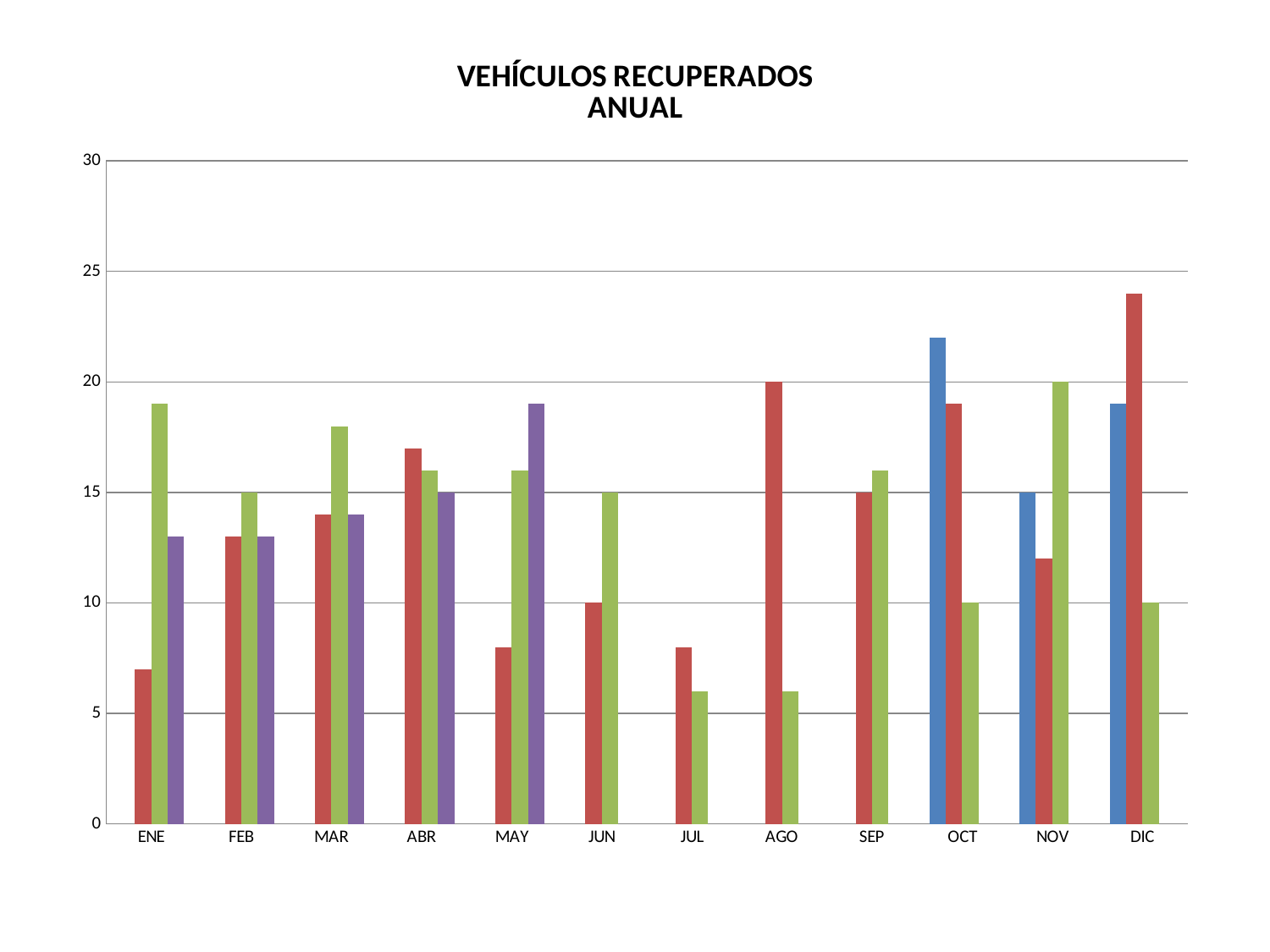
What is the value of the purple bar for ABR? 15 What is the title of the chart? VEHÍCULOS RECUPERADOS ANUAL What is the value of the green bar for NOV? 20 Is the value of the blue bar for OCT greater or less than 20? greater Which month has the tallest red bar? DIC What kind of chart is shown on the slide? bar chart What is the value of the green bar for OCT? 10 What is the difference between the red bar for AGO and the red bar for JUN? 10 What is the value of the red bar for AGO? 20 How many months are shown along the x axis? 12 What is the value of the red bar for SEP? 15 Is the value of the green bar for ENE greater or less than 15? greater